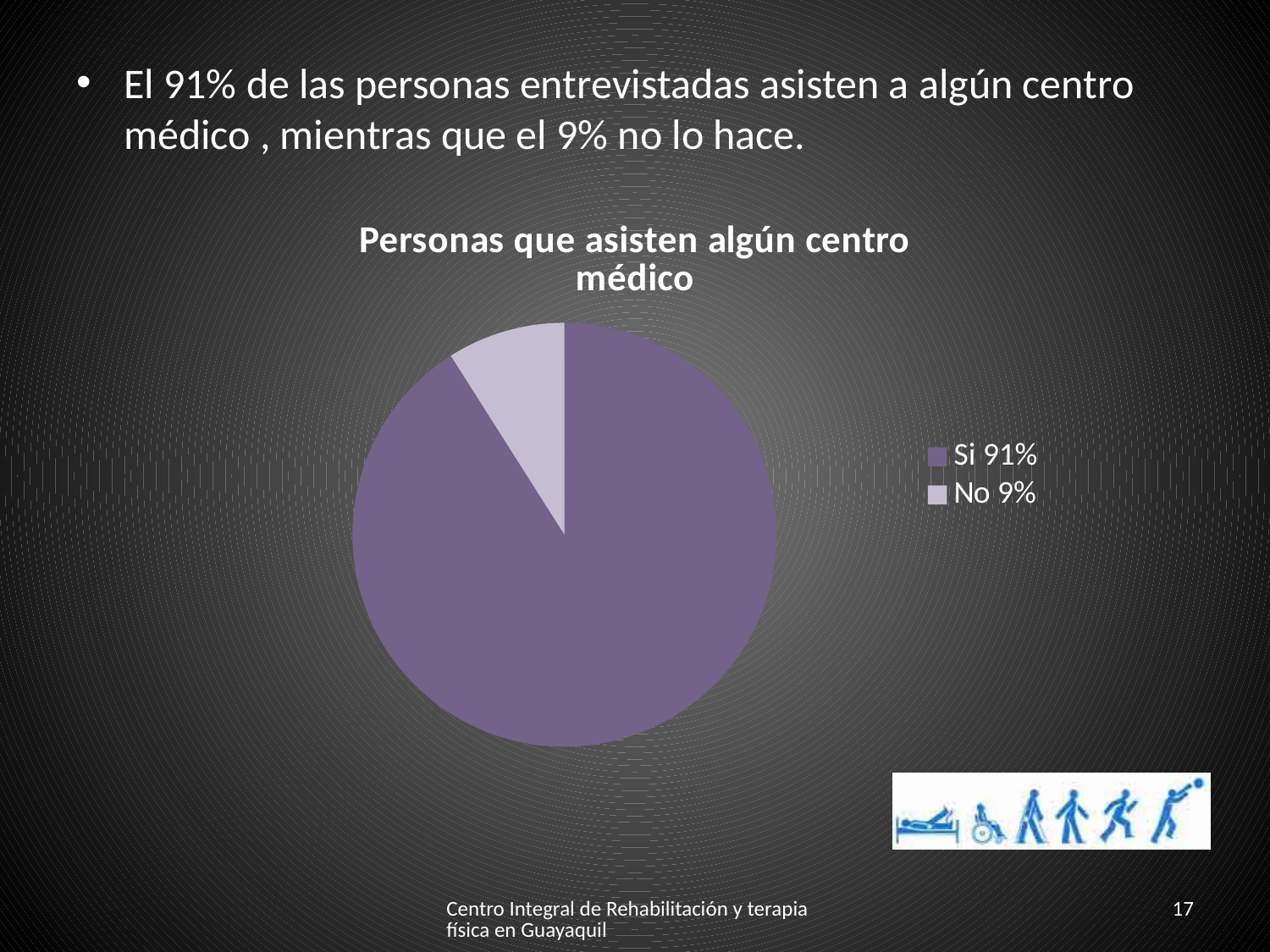
Which slice is the smallest in the pie chart? No What share of the pie does the 'No' slice represent? 9% Which slice is the largest in the pie chart? Si What is the difference in percentage points between the 'Si' and 'No' slices? 82 How many slices does the pie chart have? 2 Which is larger, the 'Si' slice or the 'No' slice? Si Which legend entry is shown in the lighter colour? No 9% What kind of chart is shown on the slide? pie chart What is the title of the chart? Personas que asisten algún centro médico How many entries does the legend list? 2 What share of the pie does the 'Si' slice represent? 91%